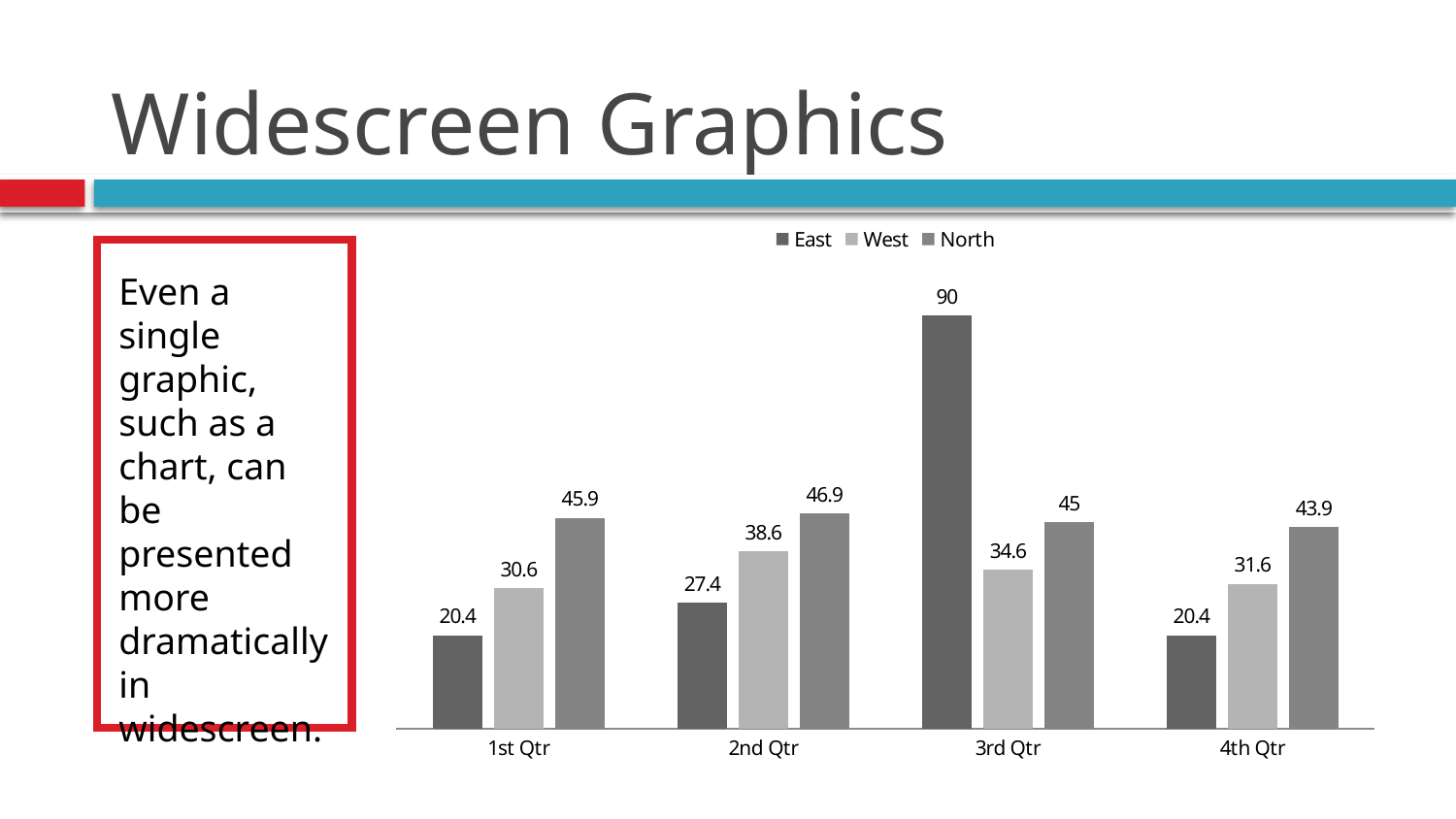
How many quarters are shown on the x axis? 4 What is the difference between the North and East values in 1st Qtr? 25.5 Which quarter has the lowest value for West? 1st Qtr What is the value for West in 2nd Qtr? 38.6 Which quarter has the highest value for East? 3rd Qtr What kind of chart is shown on the slide? Bar chart What is the value for North in 4th Qtr? 43.9 What are the three series named in the legend? East, West, North What is the value for East in 3rd Qtr? 90 How many series does the legend list? 3 Does the West value rise or fall from 3rd Qtr to 4th Qtr? Fall Which is larger in 2nd Qtr, the West value or the North value? North